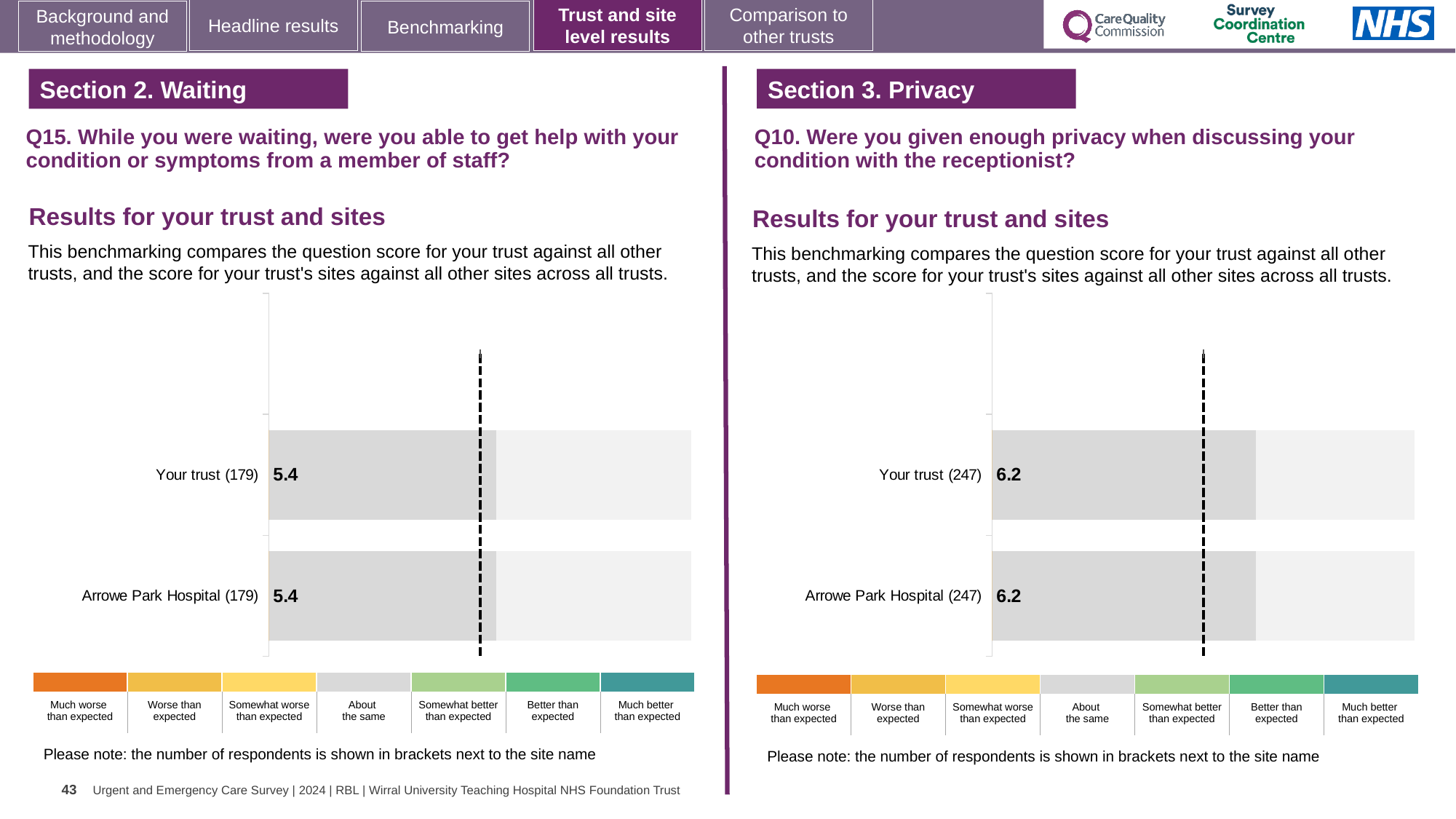
On the Section 3 Privacy chart (Q10), what is the difference between the Your trust score and the Arrowe Park Hospital score? 0 How many bars are plotted on the Section 2 Waiting chart (Q15)? 2 What kind of chart is used on the Section 3 Privacy chart (Q10)? Bar chart On the Section 3 Privacy chart (Q10), how many respondents are shown in brackets next to Your trust? 247 On the Section 3 Privacy chart (Q10), what is the score for Your trust? 6.2 On the Section 2 Waiting chart (Q15), how many respondents are shown in brackets next to Arrowe Park Hospital? 179 On the Section 2 Waiting chart (Q15), what is the score for Your trust? 5.4 How many bars are plotted on the Section 3 Privacy chart (Q10)? 2 On the Section 2 Waiting chart (Q15), what is the difference between the Your trust score and the Arrowe Park Hospital score? 0 On the Section 3 Privacy chart (Q10), what is the score for Arrowe Park Hospital? 6.2 On the Section 2 Waiting chart (Q15), what is the score for Arrowe Park Hospital? 5.4 Is the Your trust score on the Section 3 Privacy chart (Q10) larger or smaller than the Your trust score on the Section 2 Waiting chart (Q15)? Larger